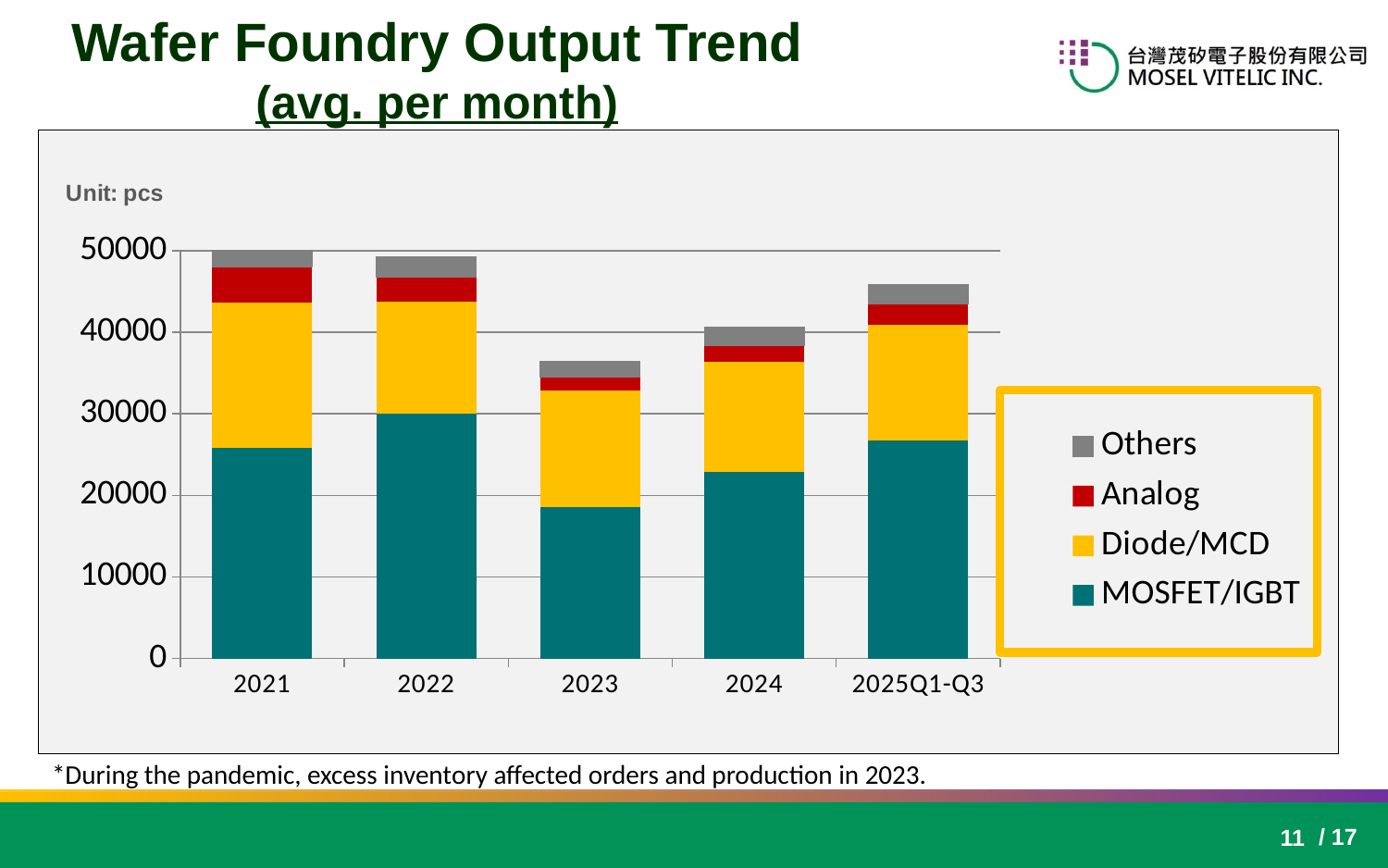
How many categories are shown on the x axis of the chart? 5 Is the MOSFET/IGBT value for 2023 greater or less than 20000? less How many series does the chart's legend list? 4 What kind of chart is shown on the slide? Stacked bar chart Is the MOSFET/IGBT value for 2021 greater or less than 20000? greater Is the total bar height for 2023 greater or less than 40000? less Which has the larger total output, 2023 or 2024? 2024 What unit is stated for the values in the chart? pcs Which category has the lowest MOSFET/IGBT value in the chart? 2023 Which year has the lowest total wafer foundry output in the chart? 2023 Do the total bar heights rise or fall from 2021 to 2023? fall